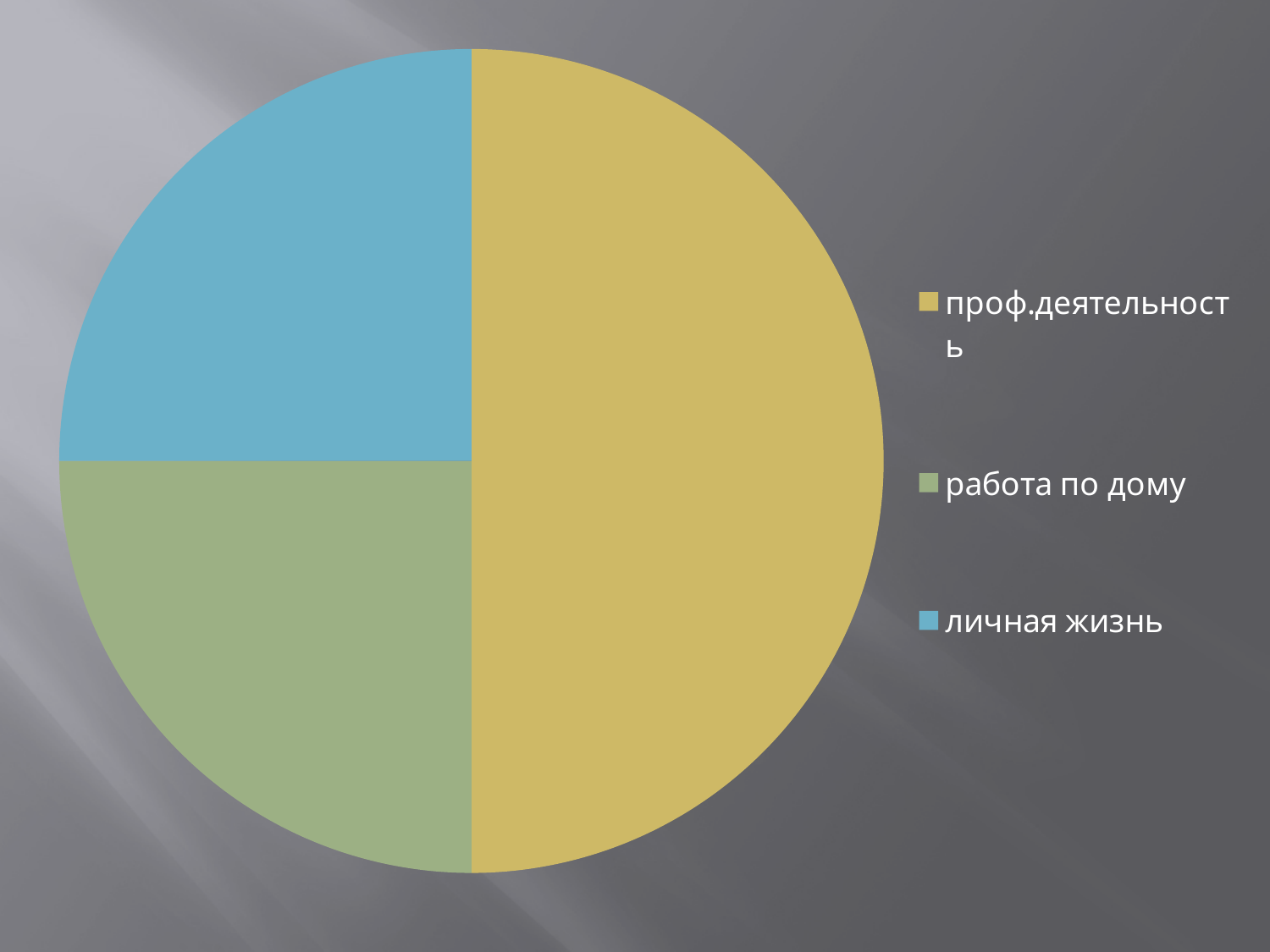
What colour is the slice for личная жизнь? blue How many entries does the legend list? 3 Which category has the largest slice of the pie? проф.деятельность Which is larger: the slice for проф.деятельность or the slice for работа по дому? проф.деятельность How many slices does the pie chart have? 3 What kind of chart is shown on the slide? pie chart Which is larger: the slice for проф.деятельность or the slice for личная жизнь? проф.деятельность Which category is shown in yellow? проф.деятельность